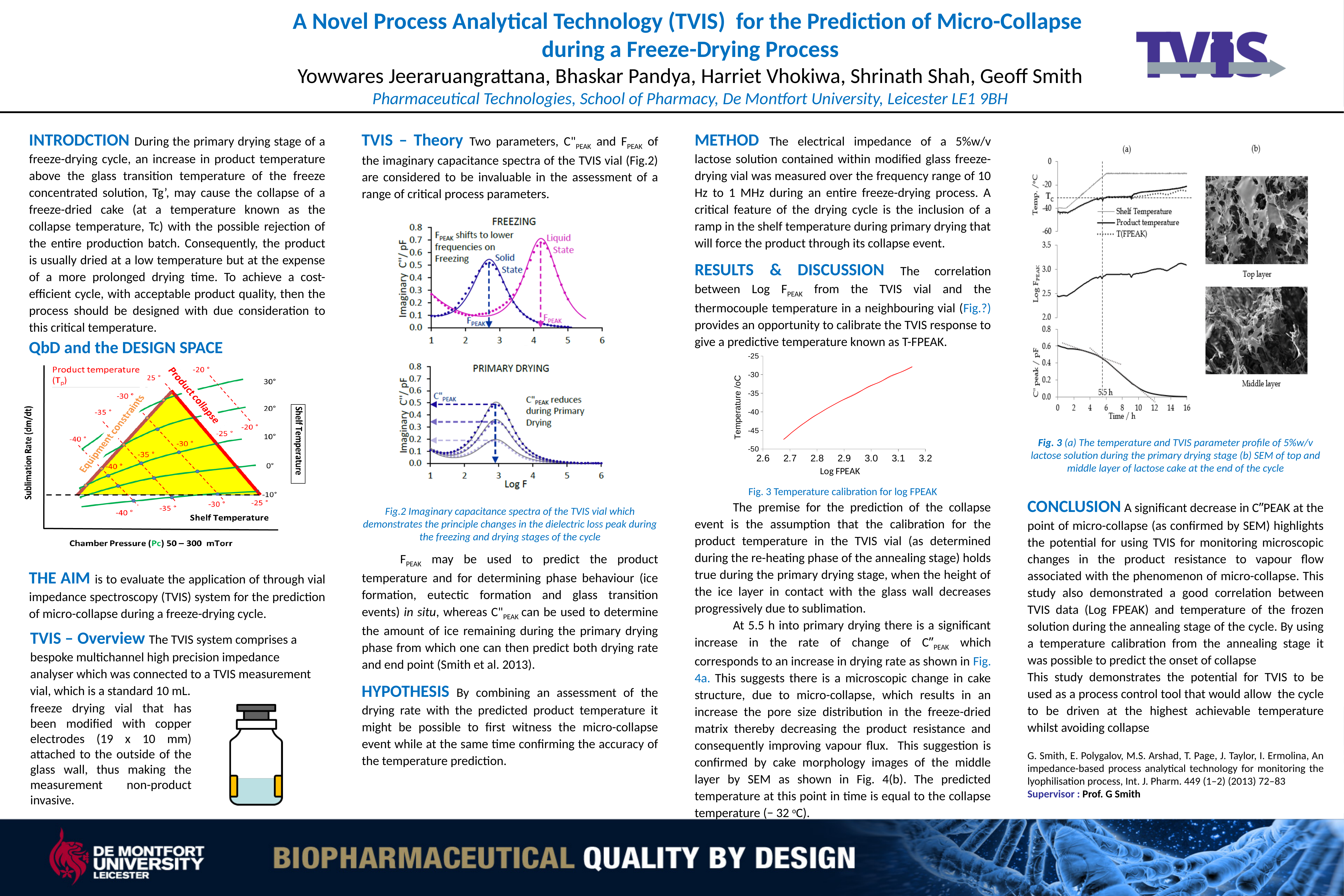
In the FREEZING chart of Fig. 2, is the Solid State peak value greater or less than 0.4? greater In the 'Fig. 3 Temperature calibration for log FPEAK' chart, does the temperature rise or fall as Log FPEAK increases? rise In the Fig. 3 (a) temperature and TVIS parameter profile chart on the right, what is the label of the x axis? Time / h What kind of chart is the PRIMARY DRYING chart in Fig. 2? line chart In the FREEZING chart of Fig. 2, which peak is higher, the Liquid State peak or the Solid State peak? Liquid State In the bottom panel of the Fig. 3 (a) profile chart on the right, does C''peak rise or fall over time? fall In the 'Fig. 3 Temperature calibration for log FPEAK' chart, is the temperature at Log FPEAK 3.1 greater or less than -35? greater In the 'Fig. 3 Temperature calibration for log FPEAK' chart, what is the label of the x axis? Log FPEAK In the middle panel of the Fig. 3 (a) profile chart on the right, does Log FPEAK rise or fall over time? rise What kind of chart is the 'Fig. 3 Temperature calibration for log FPEAK' chart? line chart In the Fig. 3 (a) temperature and TVIS parameter profile chart on the right, how many series does the legend list? 3